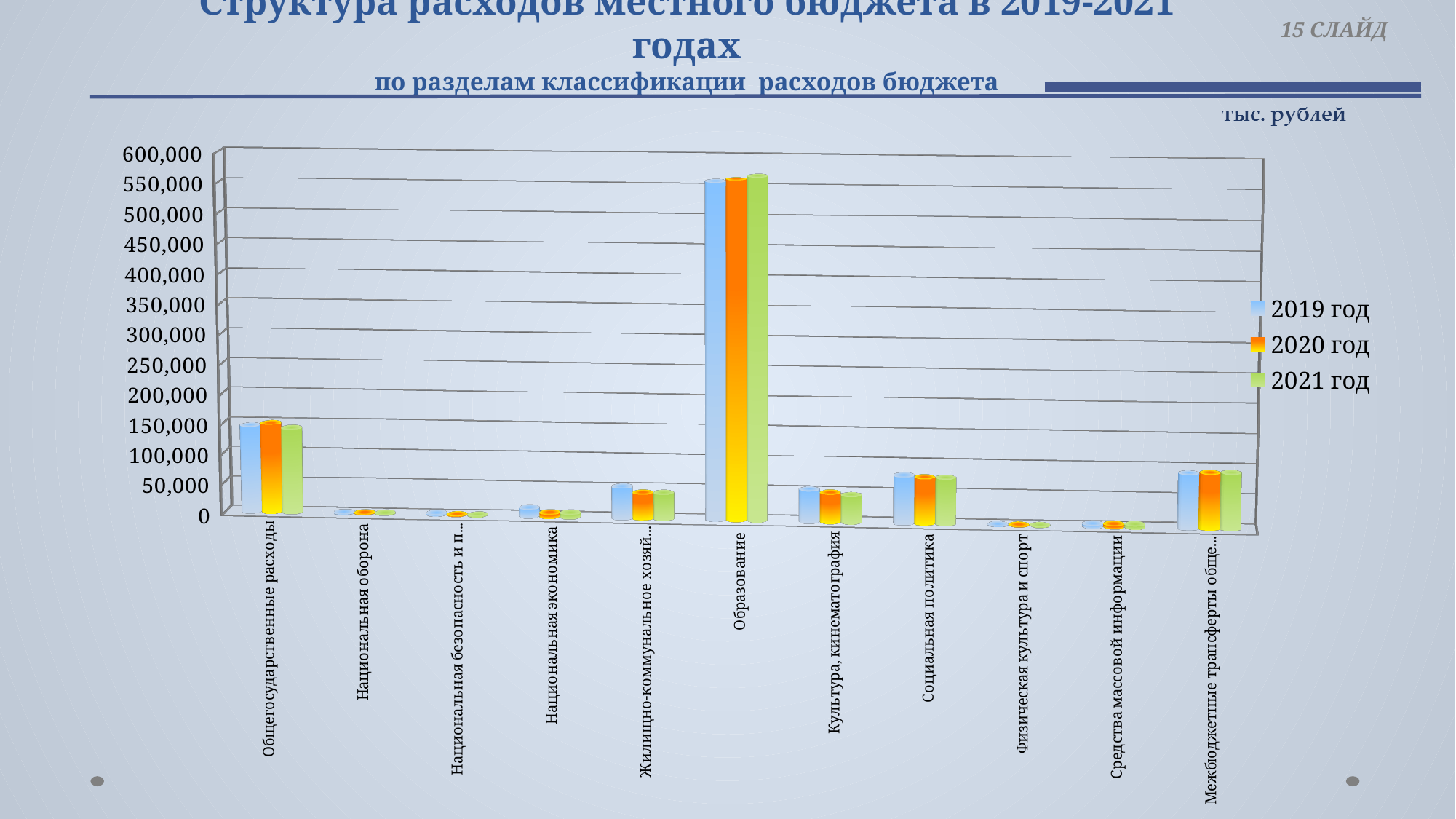
What unit of measurement is stated above the chart? тыс. рублей How many series does the legend list? 3 Is the 2019 год value for Образование greater or less than 500,000? greater How many categories are shown along the x axis? 11 Which is larger in 2019 год: Общегосударственные расходы or Национальная оборона? Общегосударственные расходы Is the 2019 год value for Социальная политика greater or less than 100,000? less What kind of chart is shown on the slide? bar chart Is the 2020 год value for Общегосударственные расходы greater or less than 100,000? greater Which category has the highest values across all three years? Образование Which is larger in 2020 год: Образование or Социальная политика? Образование